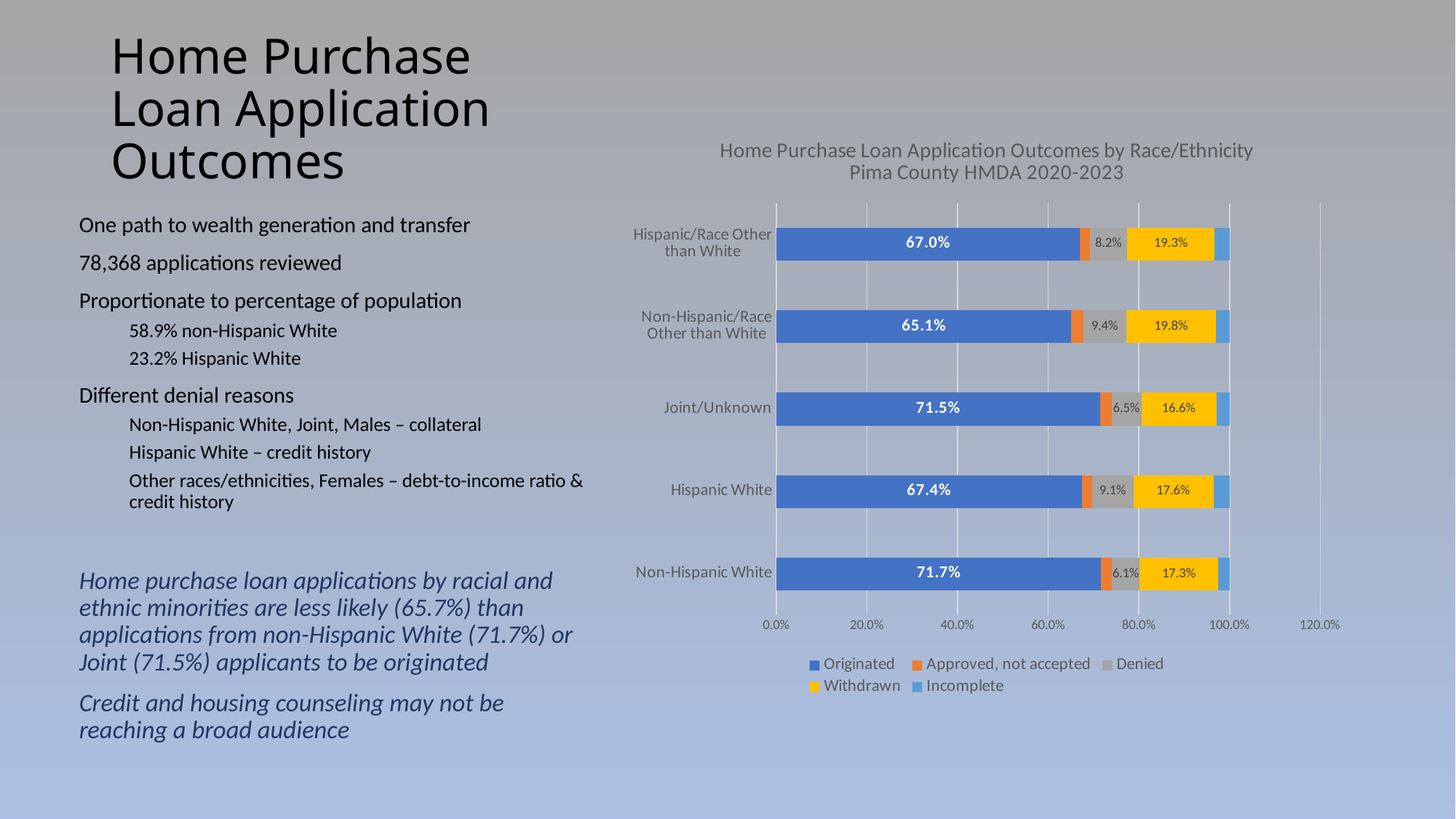
Which race/ethnicity category has the highest Originated percentage? Non-Hispanic White Which has a higher Denied percentage: Hispanic White or Hispanic/Race Other than White? Hispanic White How many series does the chart legend list? 5 Which race/ethnicity category has the lowest Withdrawn percentage? Joint/Unknown What is the Denied percentage for Joint/Unknown applicants? 6.5% How many percentage points higher is the Originated share for Non-Hispanic White than for Non-Hispanic/Race Other than White? 6.6 percentage points What is the Originated percentage for Non-Hispanic White applicants? 71.7% Which race/ethnicity category has the highest Denied percentage? Non-Hispanic/Race Other than White What is the Withdrawn percentage for Non-Hispanic/Race Other than White applicants? 19.8% How many race/ethnicity categories are shown in the chart? 5 Which race/ethnicity category has the lowest Originated percentage? Non-Hispanic/Race Other than White What type of chart is shown on the slide? Stacked bar chart